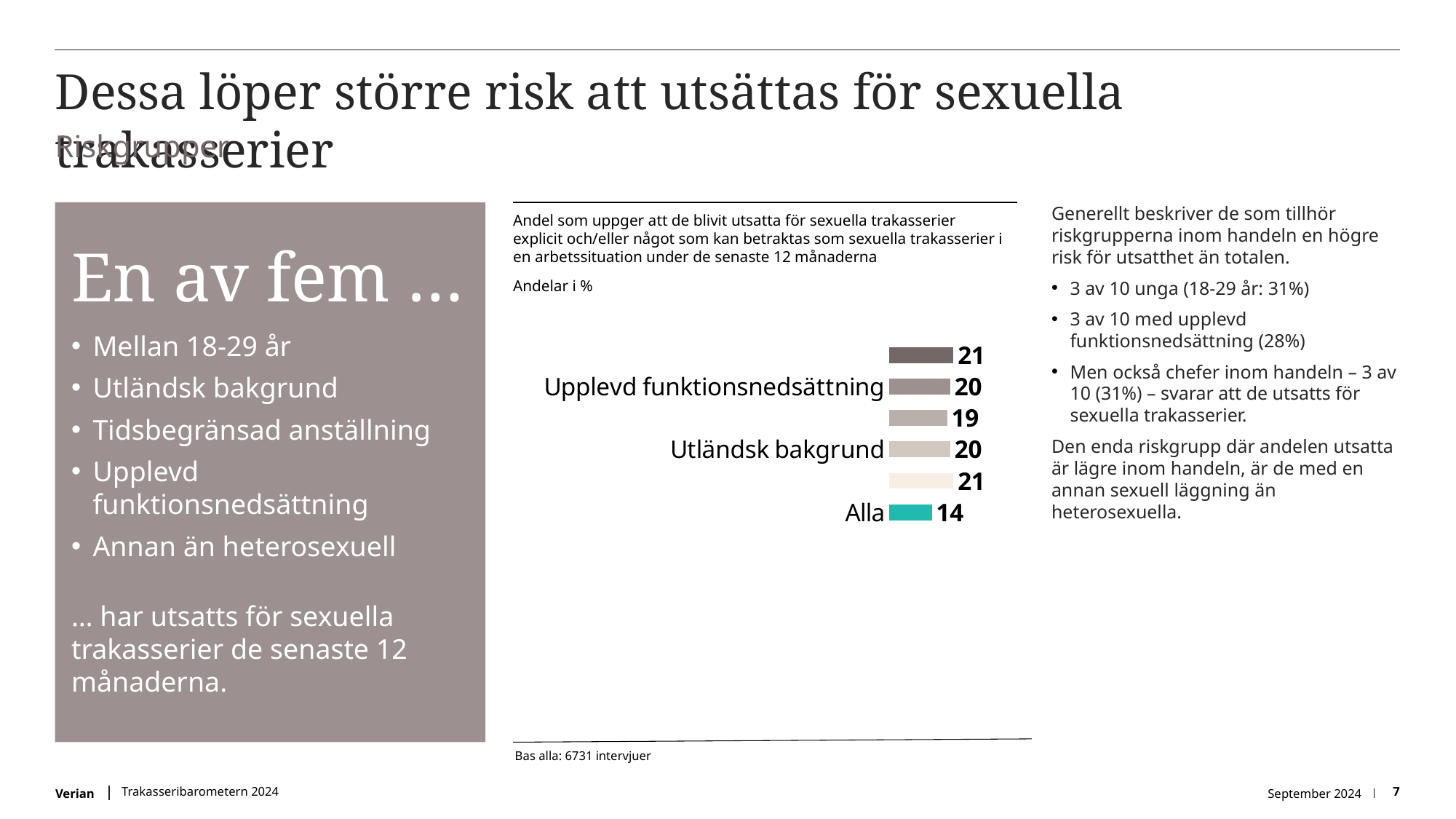
In what unit are the chart values given, according to the text above the chart? Andelar i % What colour is the bar for Alla? teal What is the difference between the values for Upplevd funktionsnedsättning and Alla? 6 Which is larger, the value for Utländsk bakgrund or the value for Alla? Utländsk bakgrund What is the difference between the values for Utländsk bakgrund and Alla? 6 What kind of chart is shown on the slide? bar chart What is the value for Alla? 14 What is the value for Upplevd funktionsnedsättning? 20 Which is larger, the value for Upplevd funktionsnedsättning or the value for Alla? Upplevd funktionsnedsättning How many bars are plotted in the chart? 6 Which category has the lowest value in the chart? Alla What is the value for Utländsk bakgrund? 20